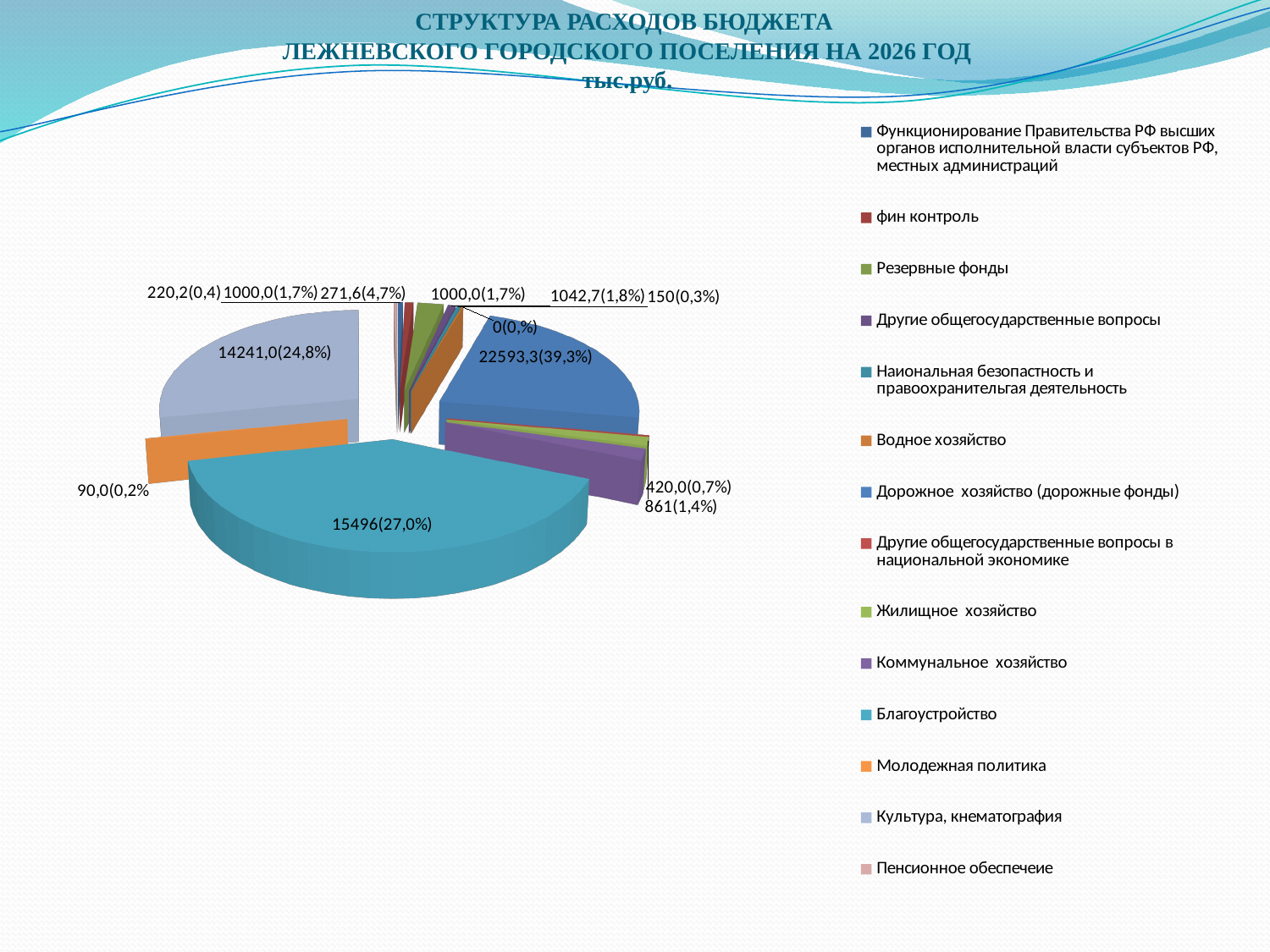
What is the difference between the slice labelled 15496 and the slice labelled 14241,0? 1255,0 How many entries does the legend of the pie chart list? 14 What value is labelled for Культура, кнематография on the pie chart? 14241,0(24,8%) What is the smallest value labelled on the pie chart? 0(0,%) What kind of chart is shown on the slide? pie chart What is the largest value labelled on the pie chart? 22593,3(39,3%) What share of the pie does the largest slice have? 39,3% Which is larger on the pie chart: the slice labelled 15496 or the slice labelled 14241,0? 15496 In what units are the values on the chart given, according to the slide title? тыс.руб. What value is labelled for Благоустройство on the pie chart? 15496(27,0%) For which year does the chart show the budget expenditure structure? 2026 What share of the pie does Благоустройство have? 27,0%